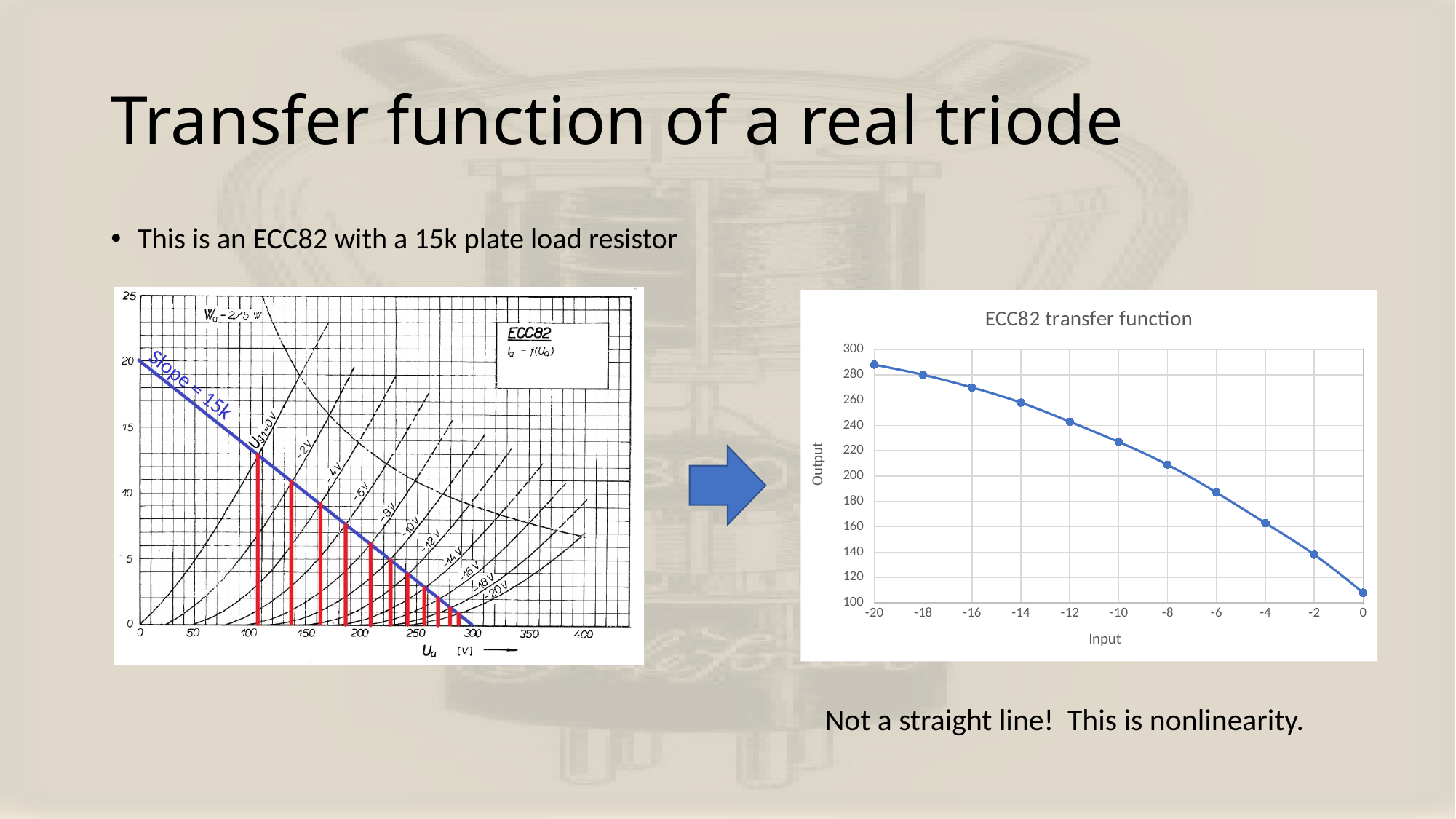
On the ECC82 transfer function chart, how many data points are plotted? 11 On the ECC82 transfer function chart, does the output rise or fall as the input increases from -20 to 0? fall What is the title of the line chart on the right of the slide? ECC82 transfer function On the ECC82 transfer function chart, which has the larger output: input -8 or input -2? -8 On the ECC82 transfer function chart, at which input value is the output highest? -20 On the ECC82 transfer function chart, is the output at input 0 greater or less than 120? less On the ECC82 transfer function chart, is the output at input -4 greater or less than 180? less On the ECC82 transfer function chart, what kind of chart is shown? line chart On the ECC82 transfer function chart, is the output at input -20 greater or less than 280? greater On the ECC82 transfer function chart, at which input value is the output lowest? 0 On the ECC82 transfer function chart, what is the label of the vertical axis? Output